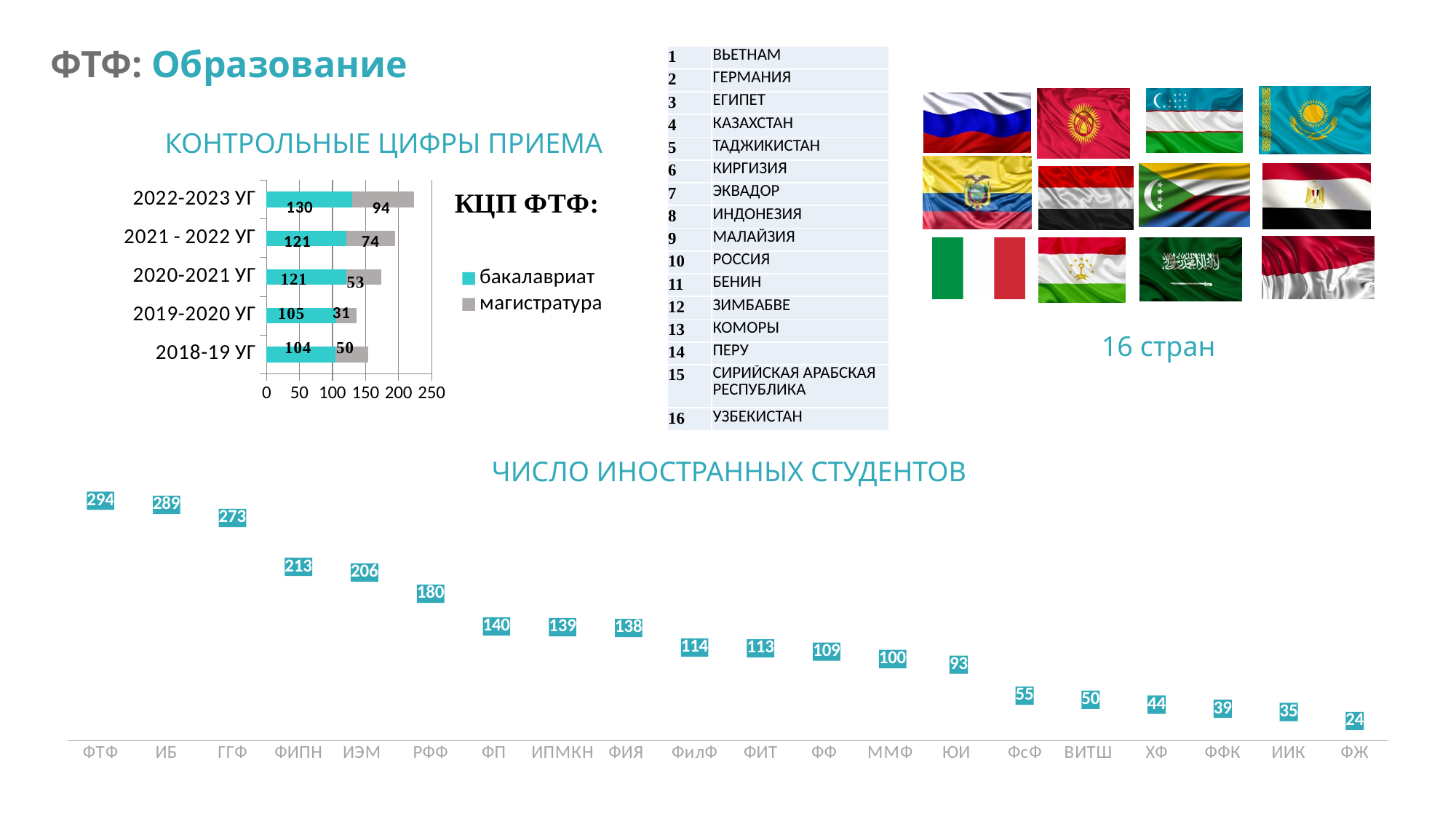
In the chart 'ЧИСЛО ИНОСТРАННЫХ СТУДЕНТОВ', how many categories are shown on the x axis? 20 In the chart 'ЧИСЛО ИНОСТРАННЫХ СТУДЕНТОВ', which category has the lowest value? ФЖ In the chart 'КОНТРОЛЬНЫЕ ЦИФРЫ ПРИЕМА', what is the total of the stacked bar for 2022-2023 УГ? 224 In the chart 'КОНТРОЛЬНЫЕ ЦИФРЫ ПРИЕМА', what is the difference between the магистратура values for 2021 - 2022 УГ and 2020-2021 УГ? 21 In the chart 'ЧИСЛО ИНОСТРАННЫХ СТУДЕНТОВ', what is the value for ФИПН? 213 In the chart 'КОНТРОЛЬНЫЕ ЦИФРЫ ПРИЕМА', what is the бакалавриат value for 2022-2023 УГ? 130 In the chart 'КОНТРОЛЬНЫЕ ЦИФРЫ ПРИЕМА', what kind of chart is it? Stacked bar chart In the chart 'ЧИСЛО ИНОСТРАННЫХ СТУДЕНТОВ', do the values rise or fall from left to right along the x axis? Fall In the chart 'КОНТРОЛЬНЫЕ ЦИФРЫ ПРИЕМА', which year has the highest магистратура value? 2022-2023 УГ In the chart 'КОНТРОЛЬНЫЕ ЦИФРЫ ПРИЕМА', how many series does the legend list? 2 In the chart 'ЧИСЛО ИНОСТРАННЫХ СТУДЕНТОВ', what is the difference between the values for ФТФ and ИБ? 5 In the chart 'КОНТРОЛЬНЫЕ ЦИФРЫ ПРИЕМА', what is the магистратура value for 2019-2020 УГ? 31